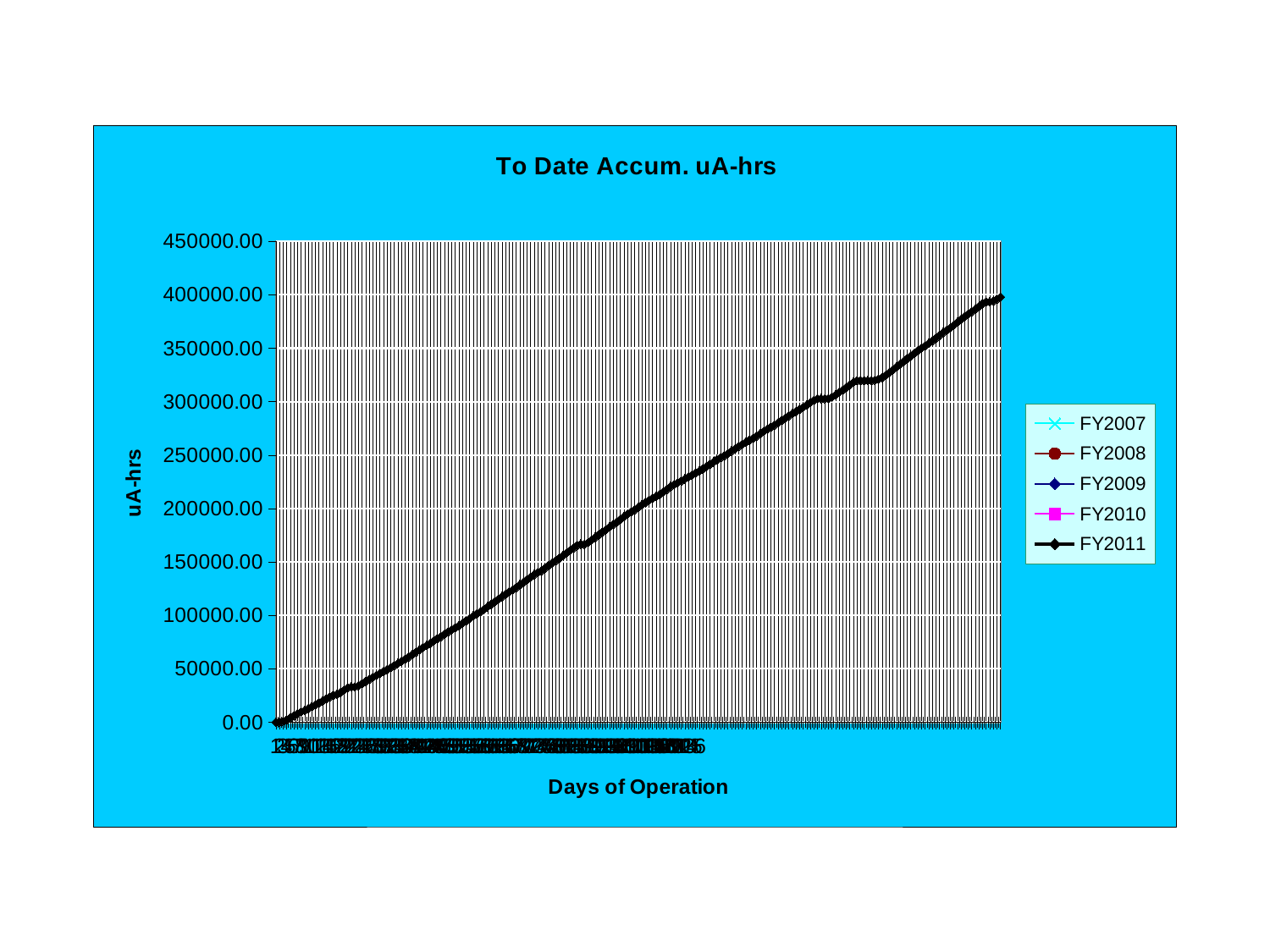
How many series does the legend list? 5 What is the label on the vertical axis of the chart? uA-hrs What is the highest tick value shown on the vertical axis? 450000.00 What kind of chart is shown on the slide? line chart Does the FY2011 line rise or fall as the days of operation increase? rise Is the starting value of the FY2011 line greater or less than 50000.00? less Is the highest value reached by the FY2011 line greater or less than 350000.00? greater What is the title of the chart? To Date Accum. uA-hrs Which series in the legend is plotted with black diamond markers? FY2011